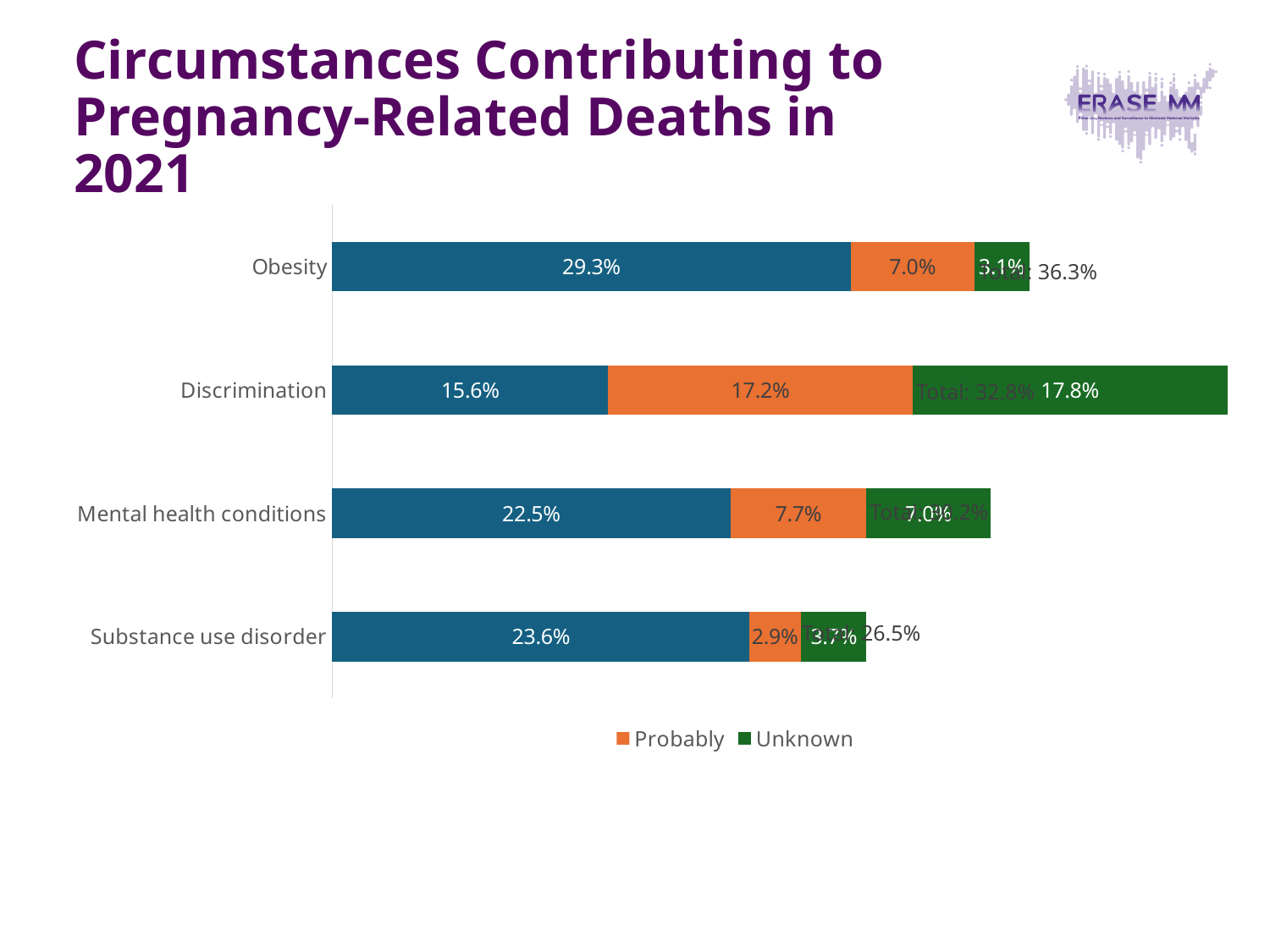
What colour represents the Unknown series in the legend? green How many categories are plotted on the chart? 4 Which category has the highest Probably value? Discrimination How many series does the chart's legend list? 2 Which category has the highest Unknown value? Discrimination What is the difference between the Probably value for Discrimination and the Probably value for Obesity? 10.2 percentage points What is the Unknown value for Obesity? 3.1% Which category has the lowest Probably value? Substance use disorder What kind of chart is shown on the slide? bar chart What is the Probably value for Discrimination? 17.2% Which is larger, the Unknown value for Mental health conditions or for Substance use disorder? Mental health conditions What is the value of the blue segment for Substance use disorder? 23.6%